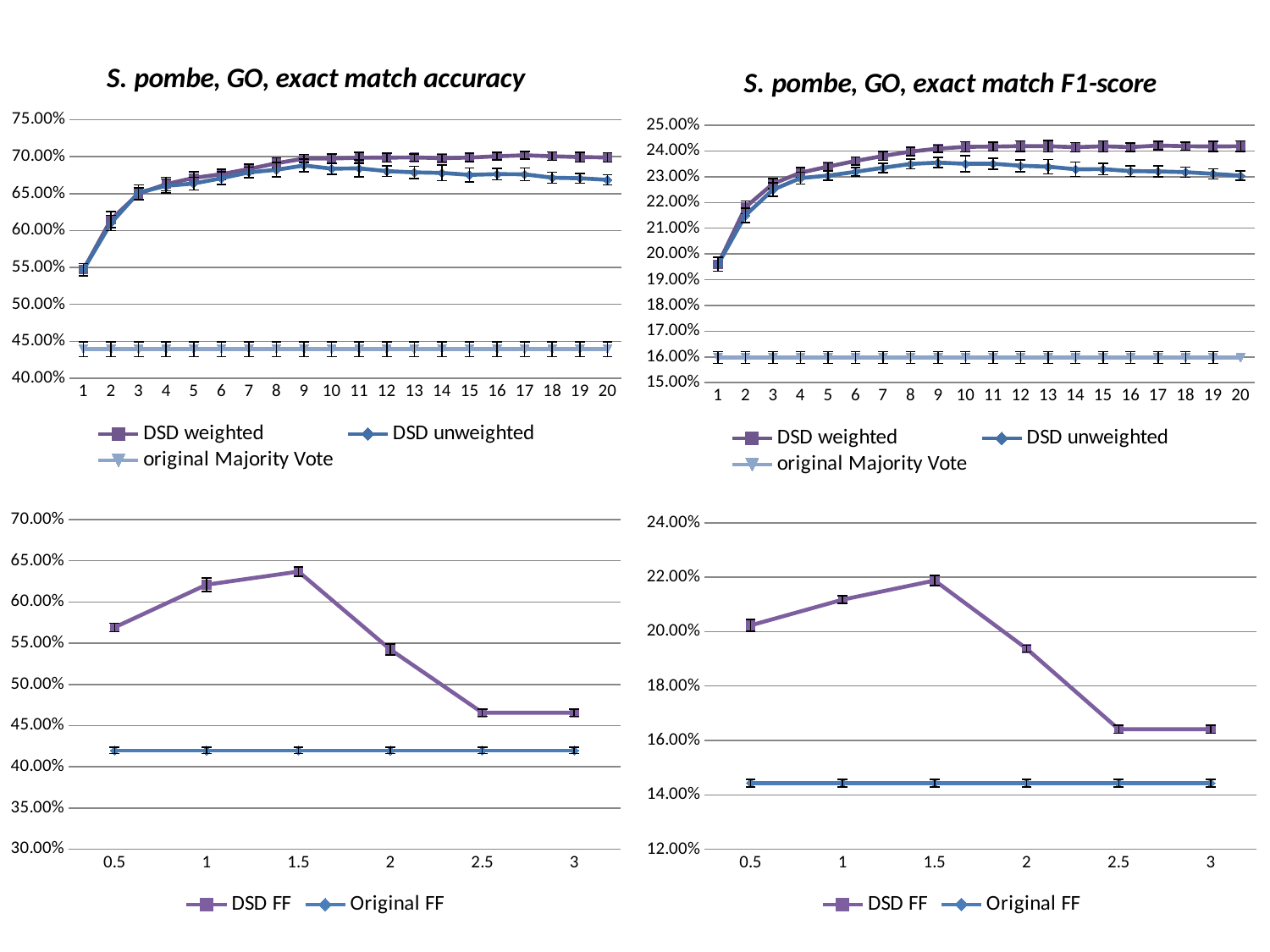
In the bottom-right chart, how many points are on the x axis? 6 In the bottom-left chart, at x = 1, which series has the larger value, DSD FF or Original FF? DSD FF In the bottom-right chart, is the value for DSD FF at x = 2.5 greater or less than 18.00%? less In the chart titled "S. pombe, GO, exact match F1-score", which series does the legend list besides DSD weighted and DSD unweighted? original Majority Vote In the chart titled "S. pombe, GO, exact match accuracy", is the value for original Majority Vote at x = 1 greater or less than 50.00%? less In the chart titled "S. pombe, GO, exact match accuracy", what kind of chart is shown? line chart In the bottom-left chart, at which x value is the DSD FF series highest? 1.5 In the chart titled "S. pombe, GO, exact match accuracy", how many series does the legend list? 3 In the chart titled "S. pombe, GO, exact match accuracy", does the DSD weighted series rise or fall from x = 1 to x = 9? rise In the chart titled "S. pombe, GO, exact match F1-score", is the value for DSD weighted at x = 20 greater or less than 23.00%? greater In the bottom-left chart, how many series does the legend list? 2 In the chart titled "S. pombe, GO, exact match accuracy", how many points are on the x axis? 20